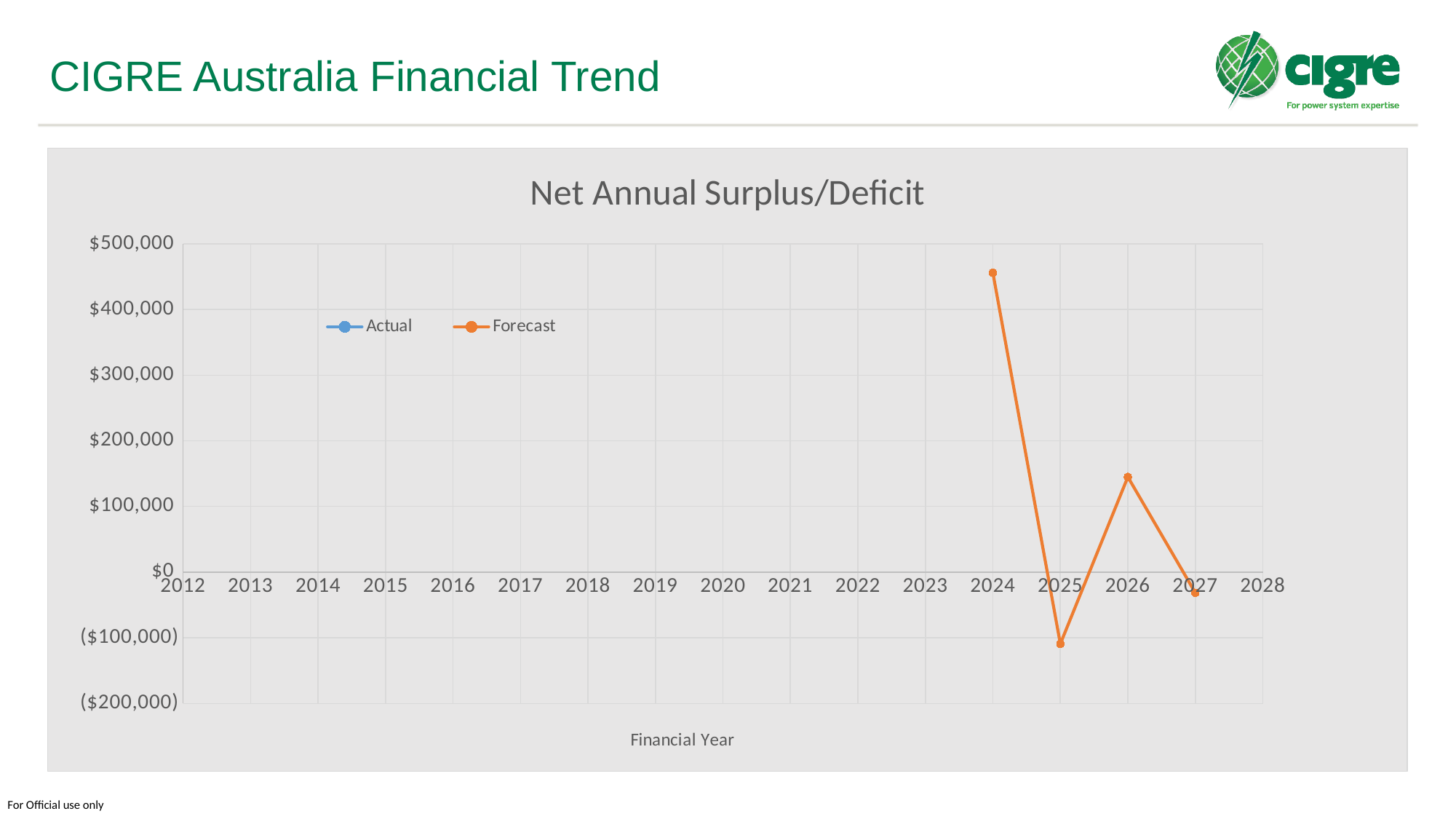
Which year has the highest Forecast value? 2024 Is the Forecast value for 2026 greater or less than $100,000? greater How many series does the chart legend list? 2 Is the Forecast value for 2025 greater or less than $0? less What is the title of the chart? Net Annual Surplus/Deficit Which is larger, the Forecast value for 2026 or the Forecast value for 2027? 2026 Is the Forecast value for 2024 greater or less than $400,000? greater How many data points are plotted for the Forecast series? 4 What kind of chart is shown on the slide? line chart Does the Forecast series rise or fall from 2024 to 2025? fall Which year has the lowest Forecast value? 2025 What is the label of the x axis? Financial Year